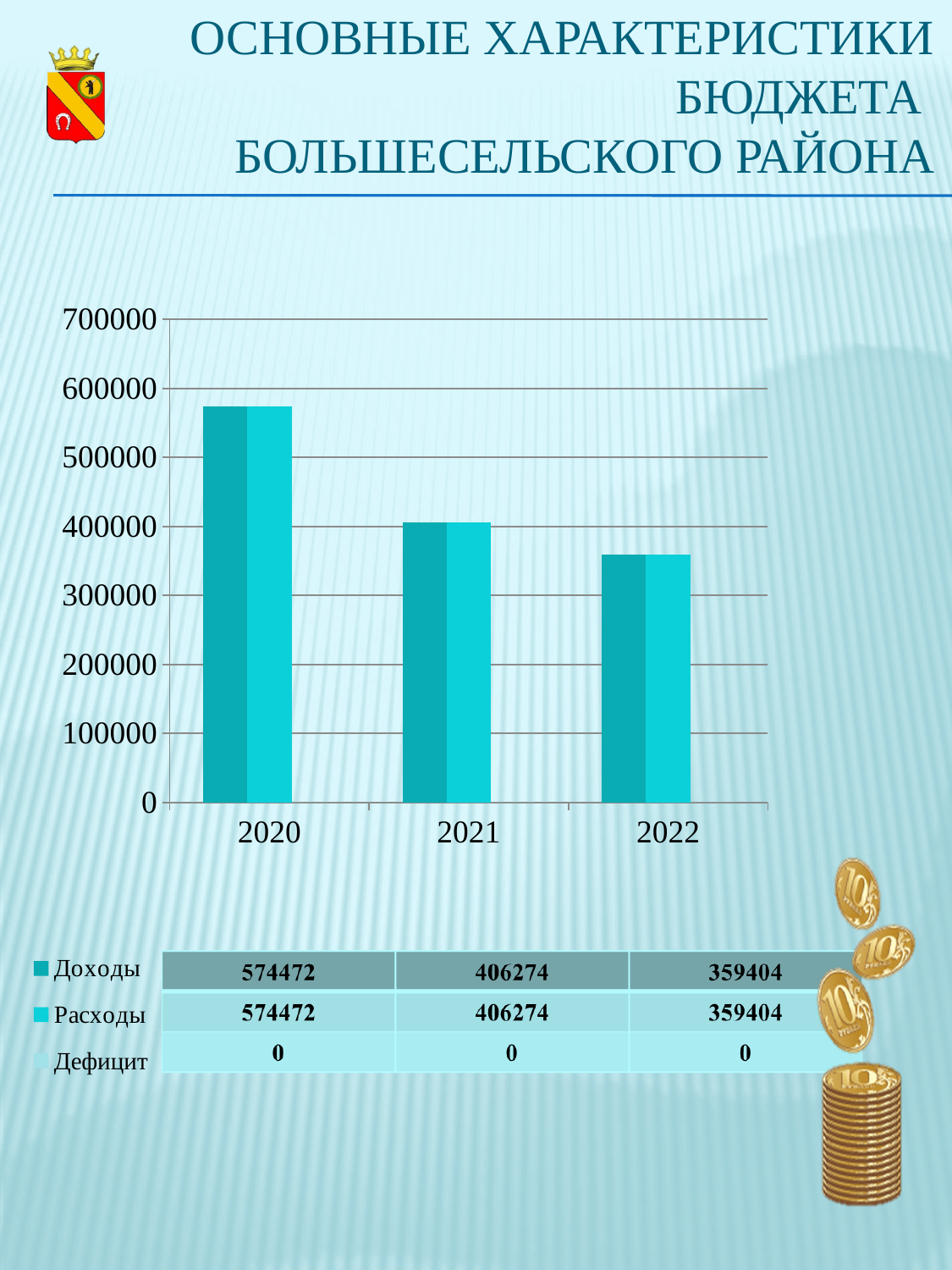
What is the value of Доходы for 2022? 359404 Is the value for Доходы in 2020 greater or less than 500000? greater What is the difference between Расходы in 2021 and Расходы in 2022? 46870 Which year has the lowest value for Расходы? 2022 How many series does the legend of the chart list? 3 What is the value of Доходы for 2020? 574472 Which is larger: Доходы in 2021 or Доходы in 2022? Доходы in 2021 Which year has the highest value for Доходы? 2020 What is the value of Дефицит for 2021? 0 How many years are shown on the x axis of the chart? 3 What is the difference between Доходы in 2020 and Доходы in 2021? 168198 What is the value of Расходы for 2021? 406274